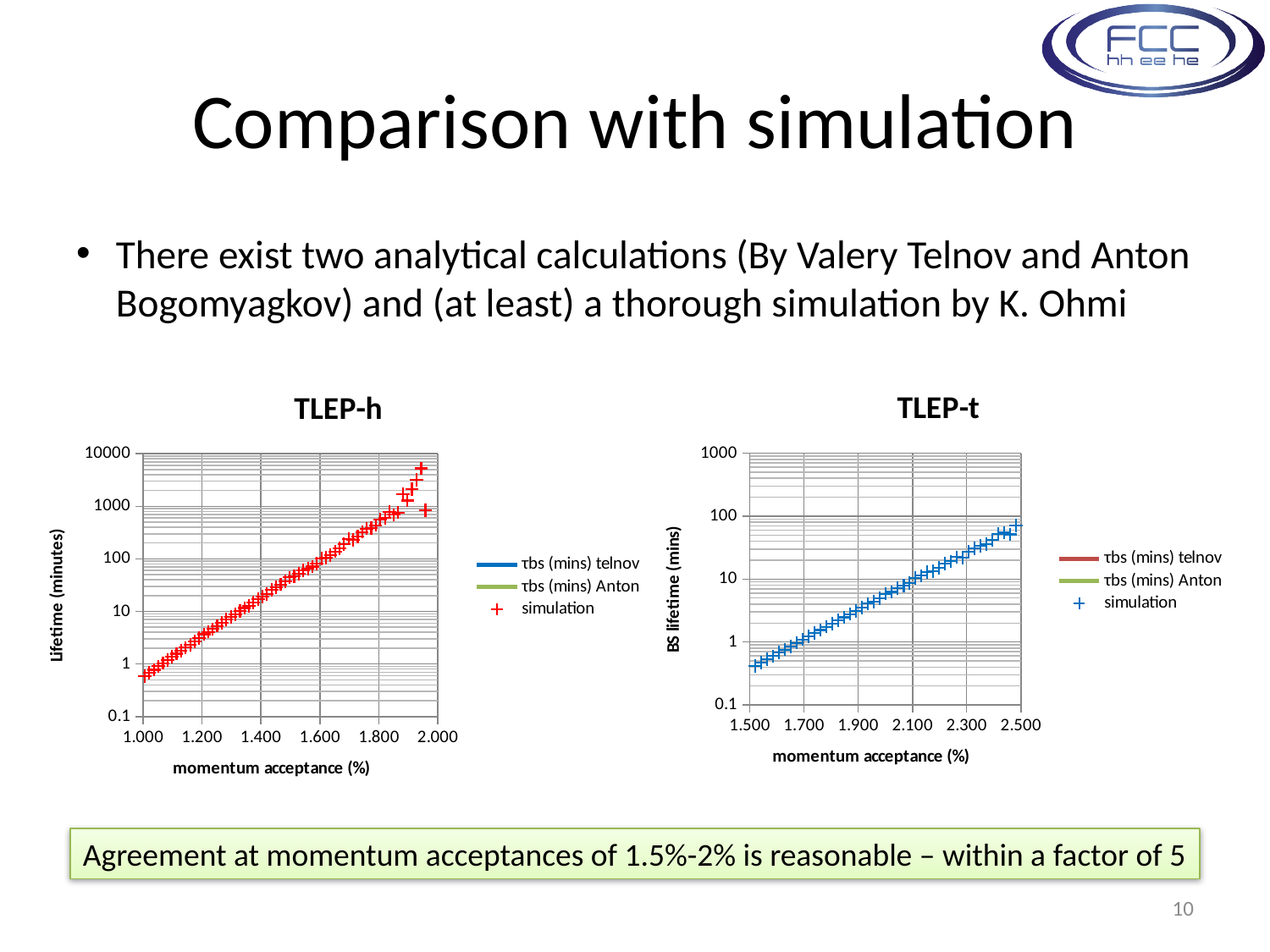
How many series does the legend of the TLEP-t chart list? 3 What is the x-axis label of the TLEP-t chart? momentum acceptance (%) How many series does the legend of the TLEP-h chart list? 3 In the TLEP-t chart, is the BS lifetime at a momentum acceptance of 1.500% greater or less than 1? less In the TLEP-h chart, is the lifetime at a momentum acceptance of 1.400% greater or less than 10? greater In the TLEP-h chart, is the lifetime at a momentum acceptance of 1.000% greater or less than 1? less In the TLEP-h chart, does the lifetime rise or fall as momentum acceptance increases? rise What is the y-axis label of the TLEP-h chart? Lifetime (minutes) What kind of chart is the TLEP-h chart? scatter chart In the TLEP-t chart, does the BS lifetime rise or fall as momentum acceptance increases? rise